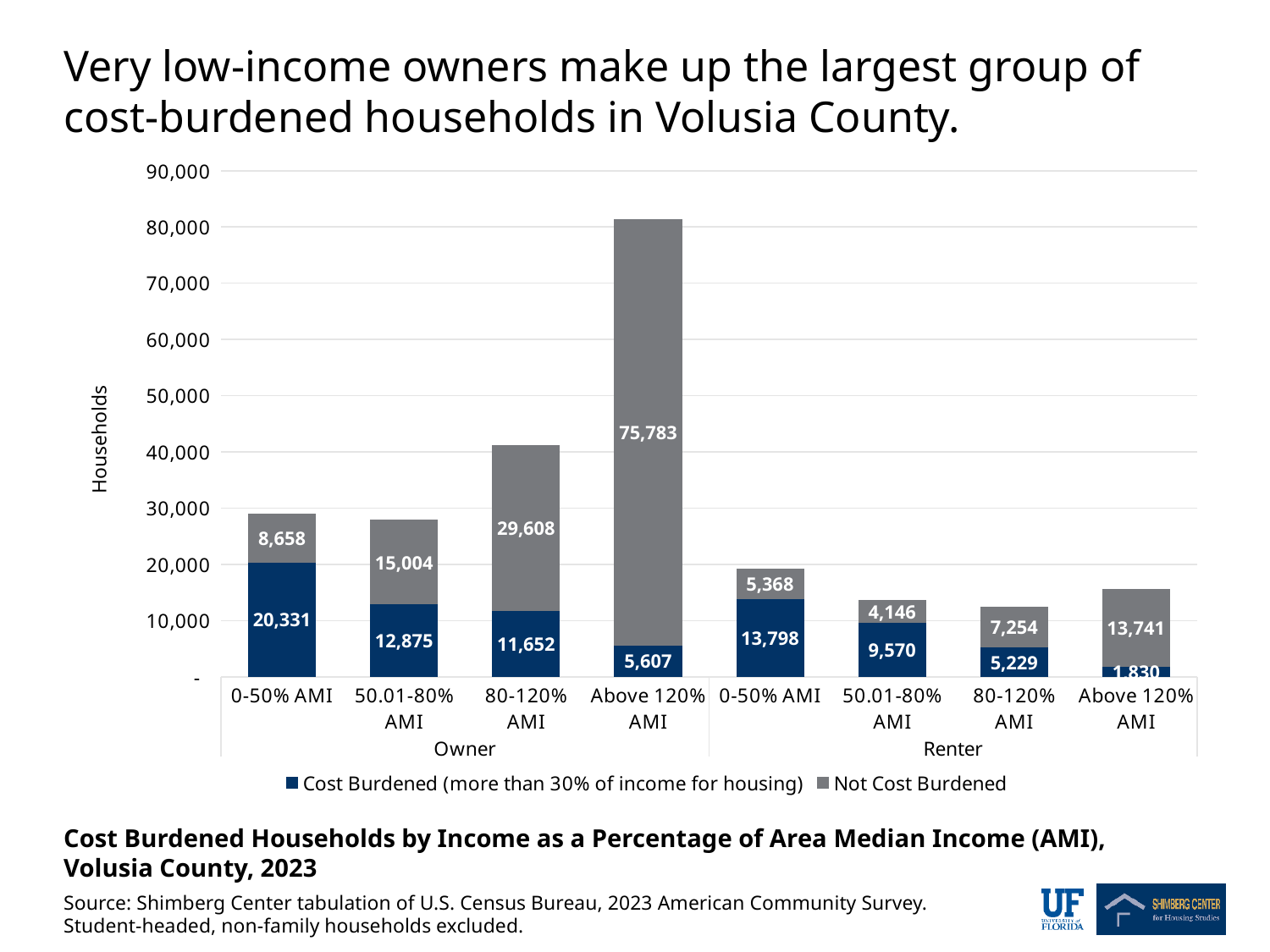
How many series does the legend list? 2 What type of chart is shown on the slide? Stacked bar chart What is the difference between Cost Burdened households for Owner 0-50% AMI and Renter 0-50% AMI? 6,533 What is the number of Cost Burdened households for Owner 0-50% AMI? 20,331 What is the total number of households (Cost Burdened plus Not Cost Burdened) for Owner Above 120% AMI? 81,390 Which category has the highest number of Cost Burdened households? Owner 0-50% AMI What is the number of Cost Burdened households for Renter Above 120% AMI? 1,830 What is the number of Not Cost Burdened households for Owner Above 120% AMI? 75,783 Which is larger: Not Cost Burdened households for Owner 80-120% AMI or for Renter 80-120% AMI? Owner 80-120% AMI What is the label of the y-axis? Households How many income categories (bars) are plotted in total across Owner and Renter? 8 Which category has the lowest number of Cost Burdened households? Renter Above 120% AMI